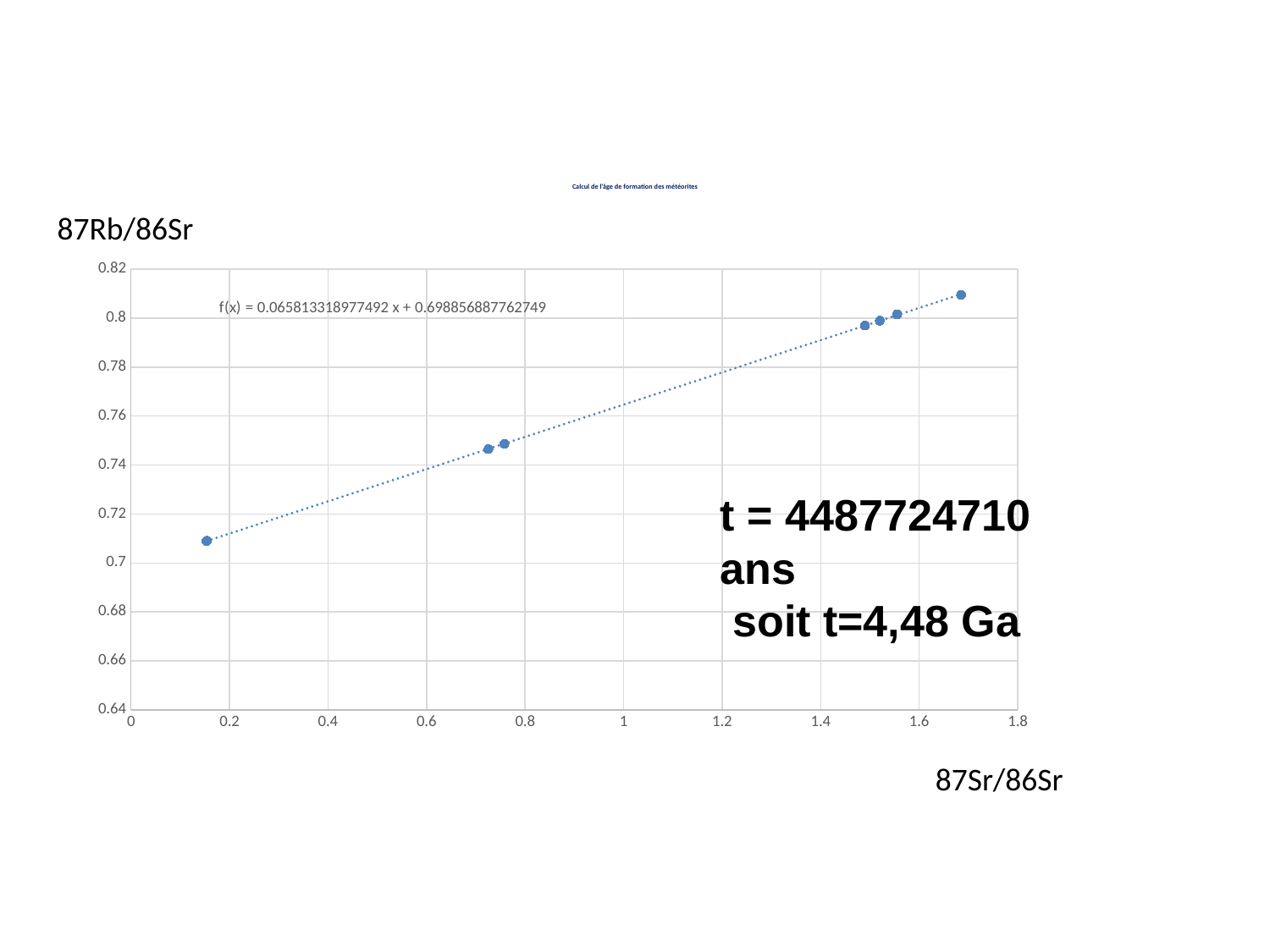
Are the y values of the data points near x = 1.5 greater or less than 0.78? greater Are the y values of the data points near x = 0.72–0.76 greater or less than 0.76? less Is the y value of the leftmost data point (near x = 0.15) greater or less than 0.7? greater What is the title of the chart? Calcul de l'âge de formation des météorites What kind of chart is shown on the slide? scatter chart Which data point has the highest 87Rb/86Sr value: the one near x = 0.15 or the one near x = 1.68? the one near x = 1.68 What is the trendline equation displayed on the chart? f(x) = 0.065813318977492 x + 0.698856887762749 Do the plotted values rise or fall as 87Sr/86Sr increases along the x axis? rise